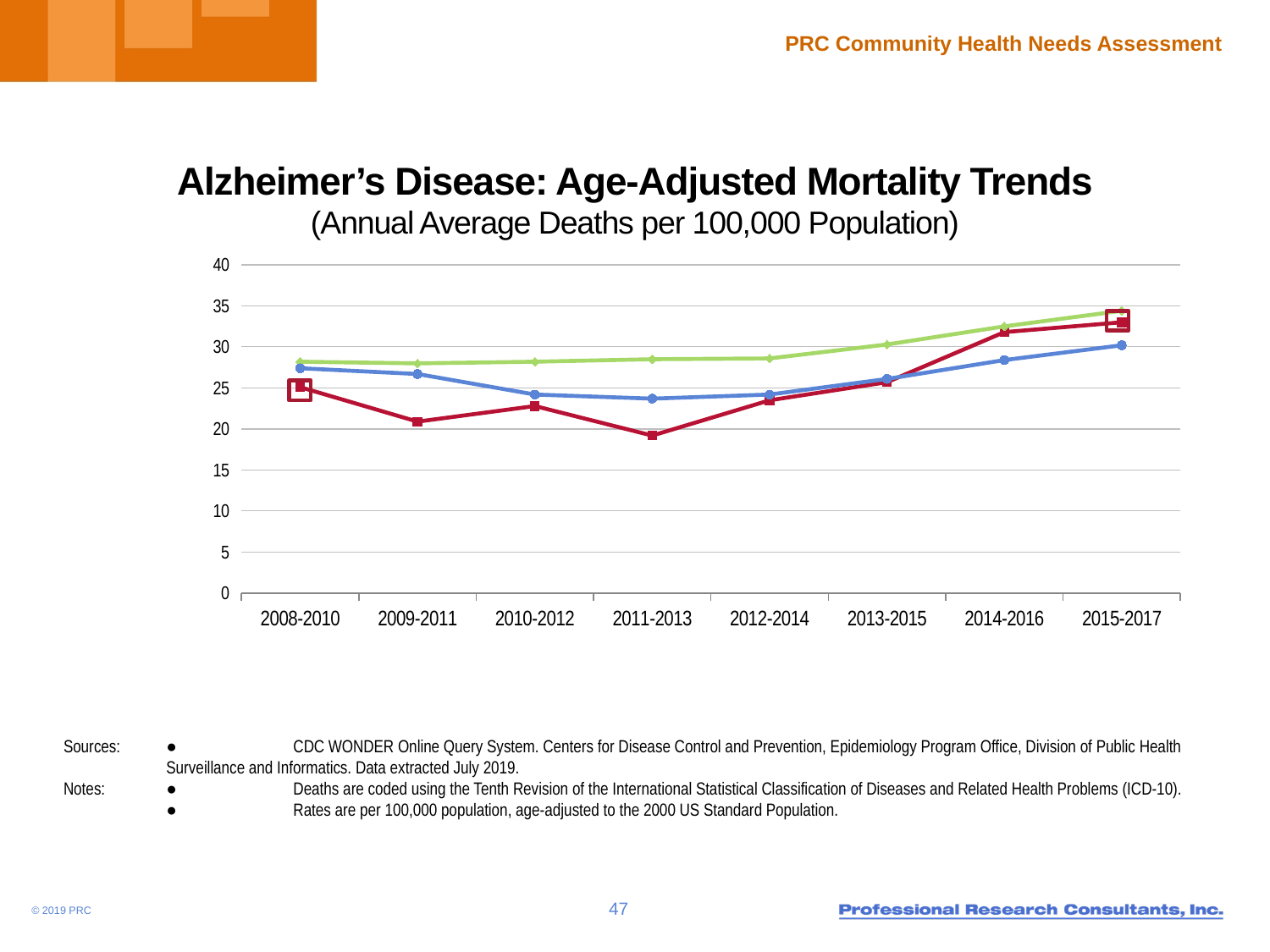
In which period does the red line (square markers) reach its lowest value? 2011-2013 In which period does the green line (diamond markers) reach its highest value? 2015-2017 Is the value of the red line for 2009-2011 greater or less than 20? greater Is the value of the green line for 2015-2017 greater or less than 30? greater How many lines (series) are plotted on the chart? 3 What kind of chart is shown on the slide? line chart Does the green line generally rise or fall from 2012-2014 to 2015-2017? rise For 2011-2013, which line has the larger value, the green line or the red line? green line What is the title of the chart? Alzheimer's Disease: Age-Adjusted Mortality Trends Is the value of the red line for 2014-2016 greater or less than 30? greater What unit does the chart subtitle say the values are in? Annual Average Deaths per 100,000 Population How many time periods are shown along the x axis? 8